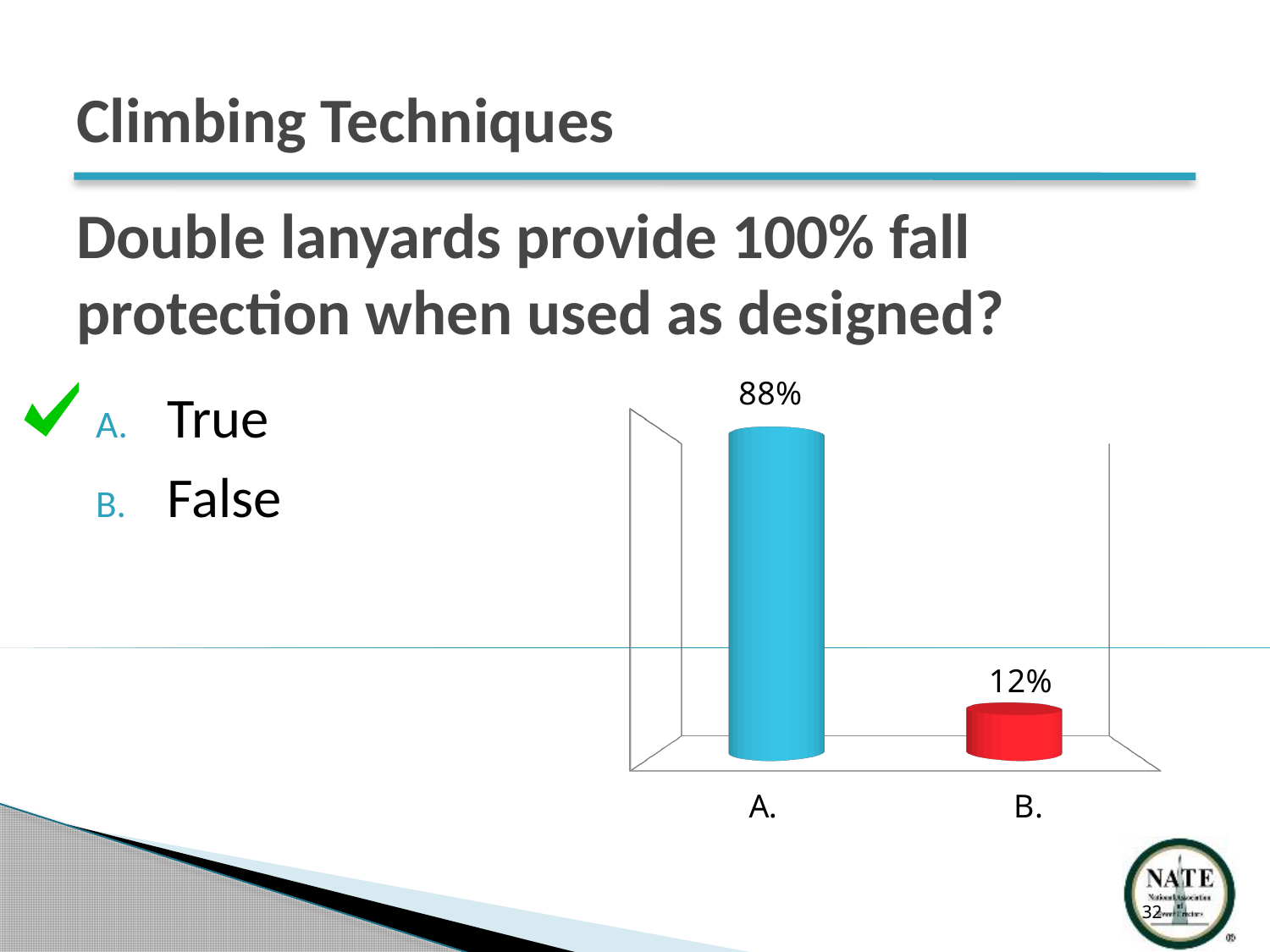
Which category has the lowest value in the chart? B. What kind of chart is shown on the slide? Bar chart What is the value for category B. in the chart? 12% What is the difference between the values for A. and B. in the chart? 76% What is the value for category A. in the chart? 88% What is the total of the values for A. and B. in the chart? 100% Do the values rise or fall from category A. to category B.? Fall What colour is the bar for category A.? Blue What colour is the bar for category B.? Red How many categories are shown in the chart? 2 Which category has the highest value in the chart? A. Which category has the larger value, A. or B.? A.